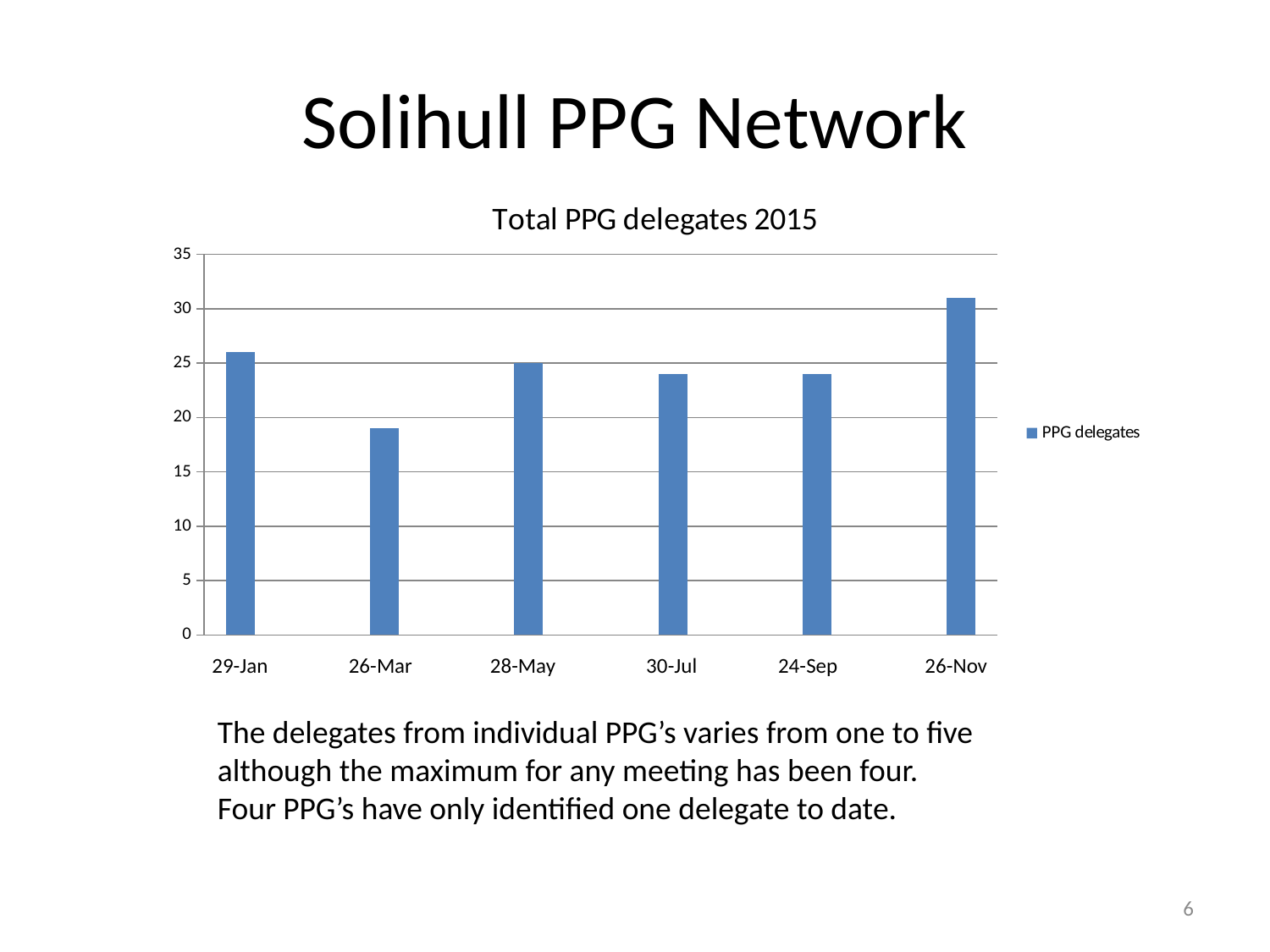
Is the value for 26-Mar greater or less than 20? less Which meeting date has the lowest number of PPG delegates? 26-Mar Is the value for 26-Nov greater or less than 30? greater Which has more PPG delegates, 26-Nov or 28-May? 26-Nov What type of chart is shown on the slide? bar chart Which has more PPG delegates, 29-Jan or 26-Mar? 29-Jan How many series does the legend list? 1 Which meeting date has the highest number of PPG delegates? 26-Nov Is the value for 29-Jan greater or less than 25? greater What is the title of the chart? Total PPG delegates 2015 What is the name of the series shown in the legend? PPG delegates How many meeting dates are shown on the x axis? 6